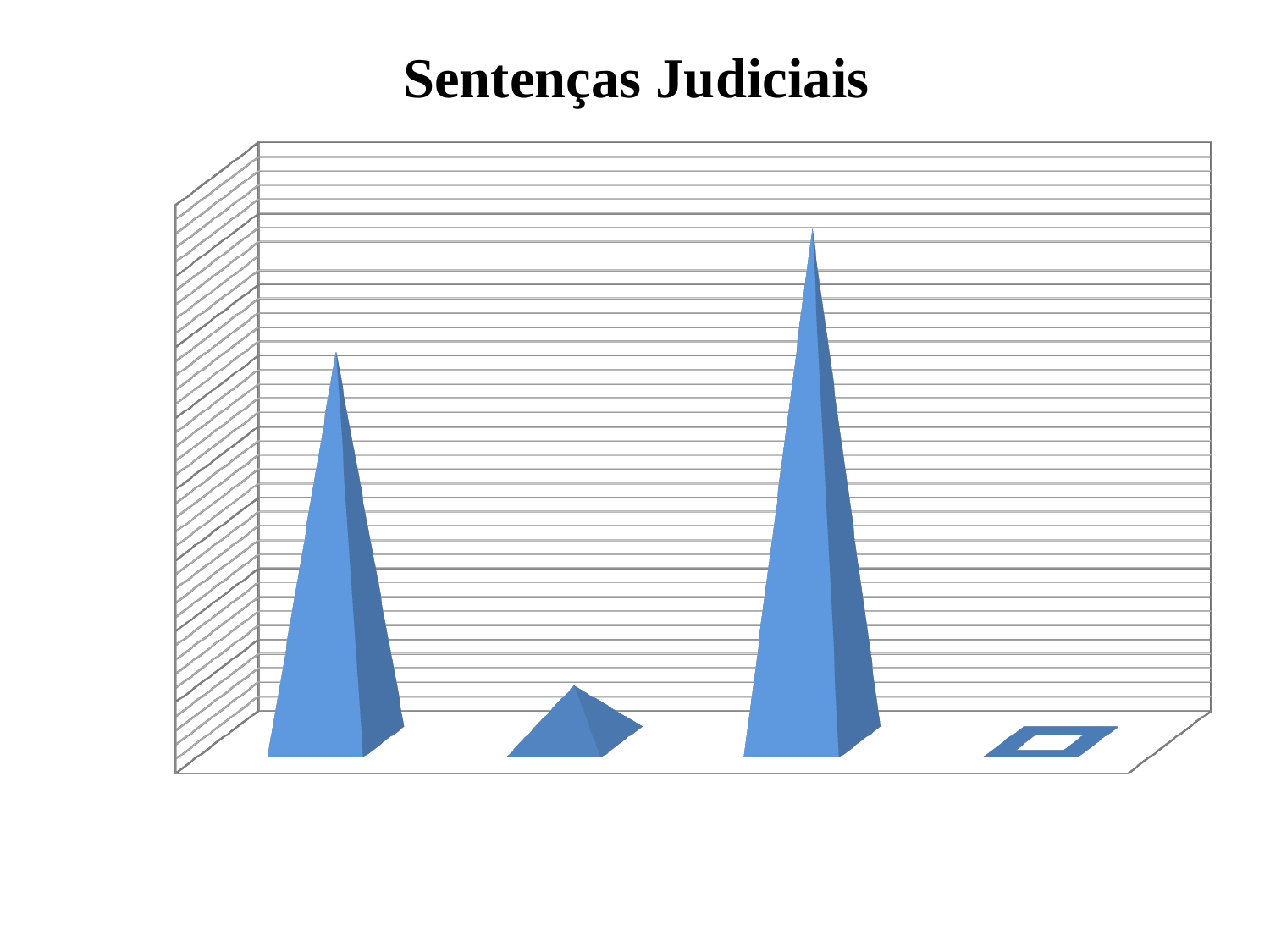
Which bar is the shortest in the chart, counting from the left? the fourth bar How many bars are plotted in the chart? 4 Is the first bar from the left taller or shorter than the third bar? shorter What is the title of the chart? Sentenças Judiciais Which bar is the tallest in the chart, counting from the left? the third bar What colour are the bars in the chart? blue Is the second bar from the left taller or shorter than the first bar? shorter What kind of chart is shown on the slide? bar chart